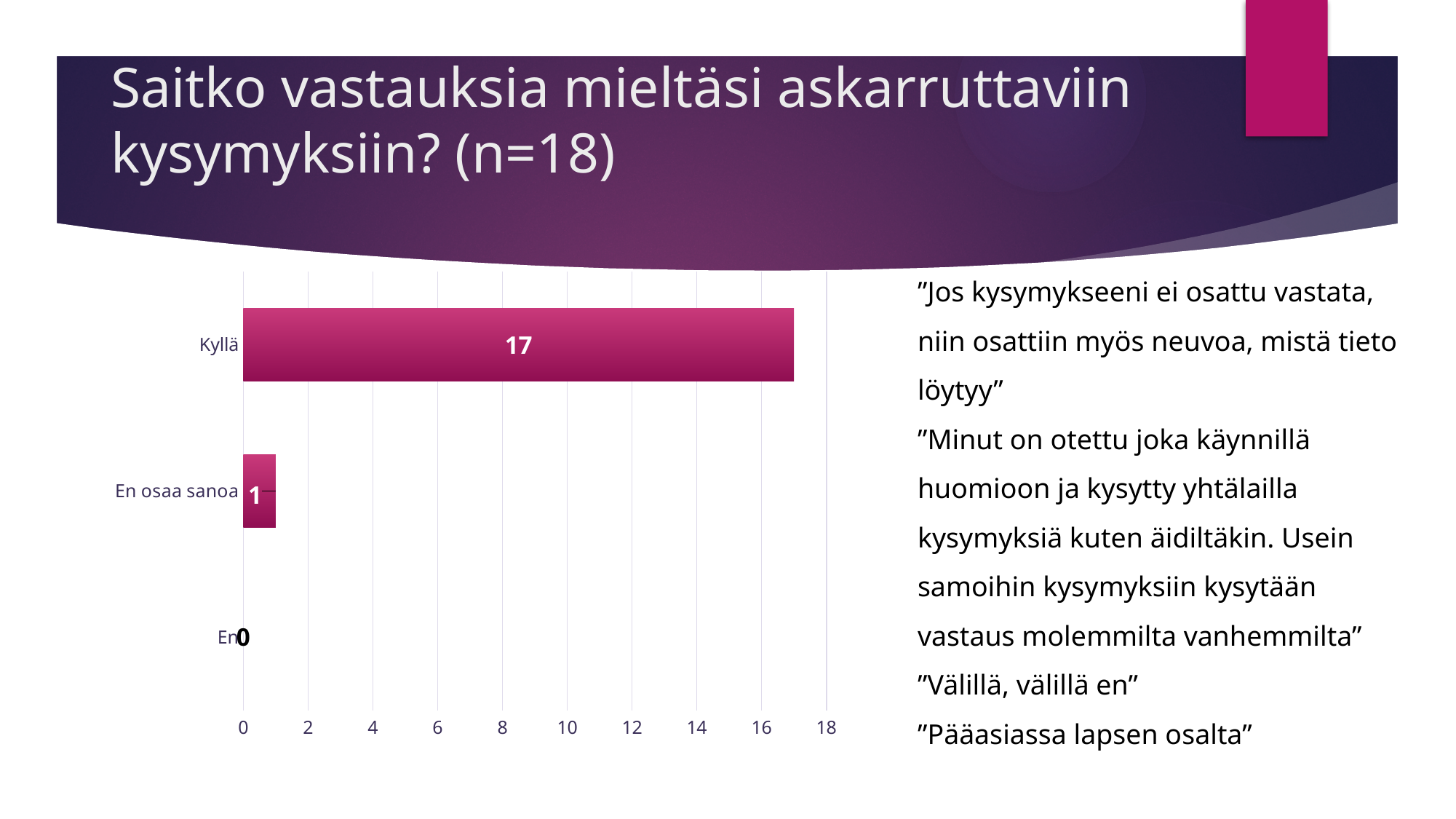
What is the value for En? 0 What is the difference between the values for Kyllä and En osaa sanoa? 16 Is the value for Kyllä greater or less than 10? greater What is the value for En osaa sanoa? 1 Which is larger, the value for Kyllä or the value for En osaa sanoa? Kyllä What is the total of all three values in the chart? 18 Which category has the lowest value? En What is the value for Kyllä? 17 Which category has the highest value? Kyllä How many categories are shown in the chart? 3 What is the highest value shown on the x axis? 18 What kind of chart is shown on the slide? bar chart